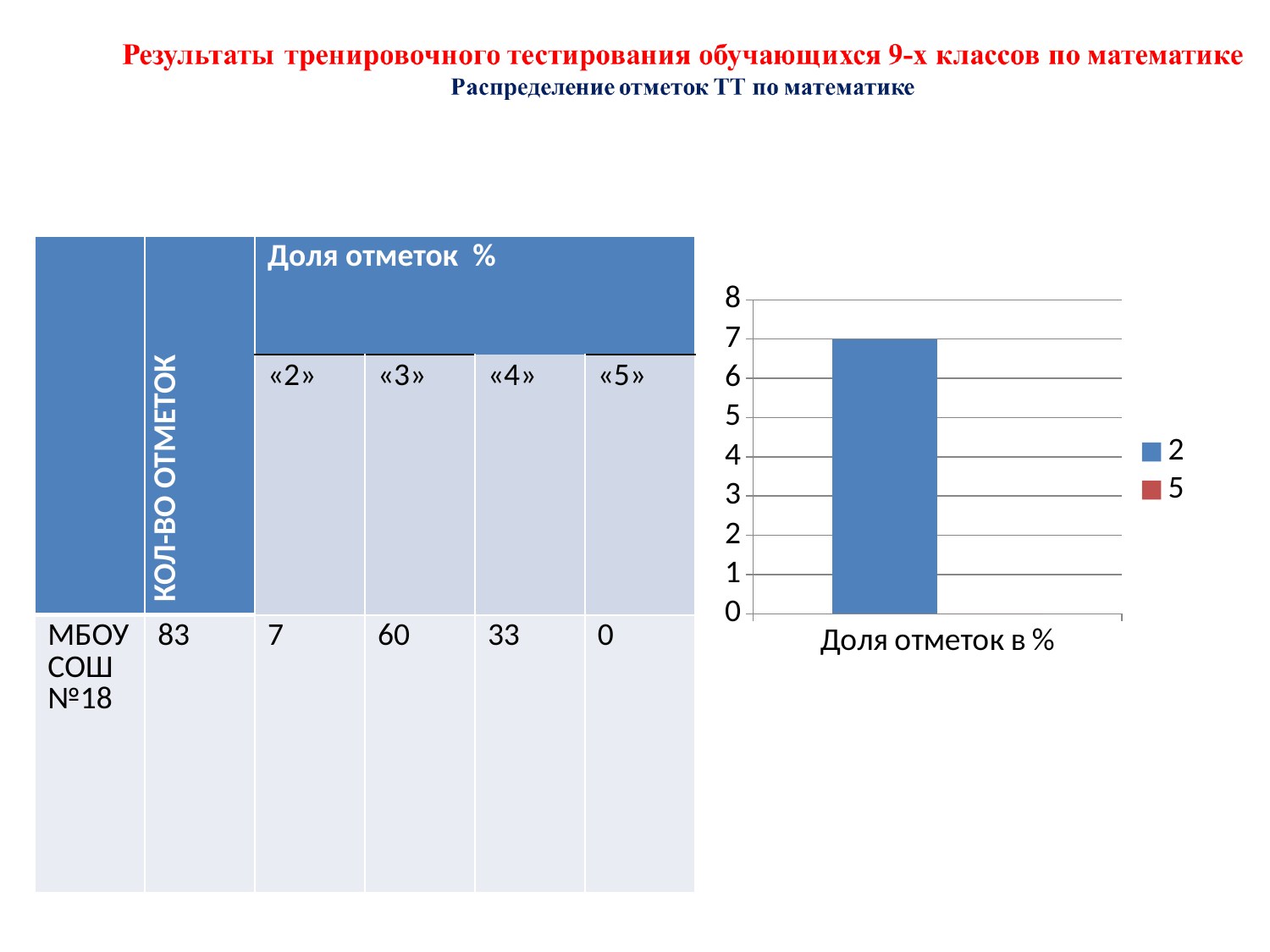
How many categories are shown on the x axis of the chart? 1 Which series has the highest value in the chart? 2 Is the value for series 2 in the chart greater or less than 5? greater What kind of chart is shown on the slide? bar chart What value does the bar for series 2 reach in the chart? 7 Is the value for series 2 in the chart greater or less than 8? less Which series has the lowest value in the chart? 5 What is the category label on the x axis of the chart? Доля отметок в % How many series does the chart legend list? 2 What is the maximum value shown on the chart's vertical axis? 8 What are the entries in the chart legend? 2 and 5 Which series has the larger value in the chart, 2 or 5? 2